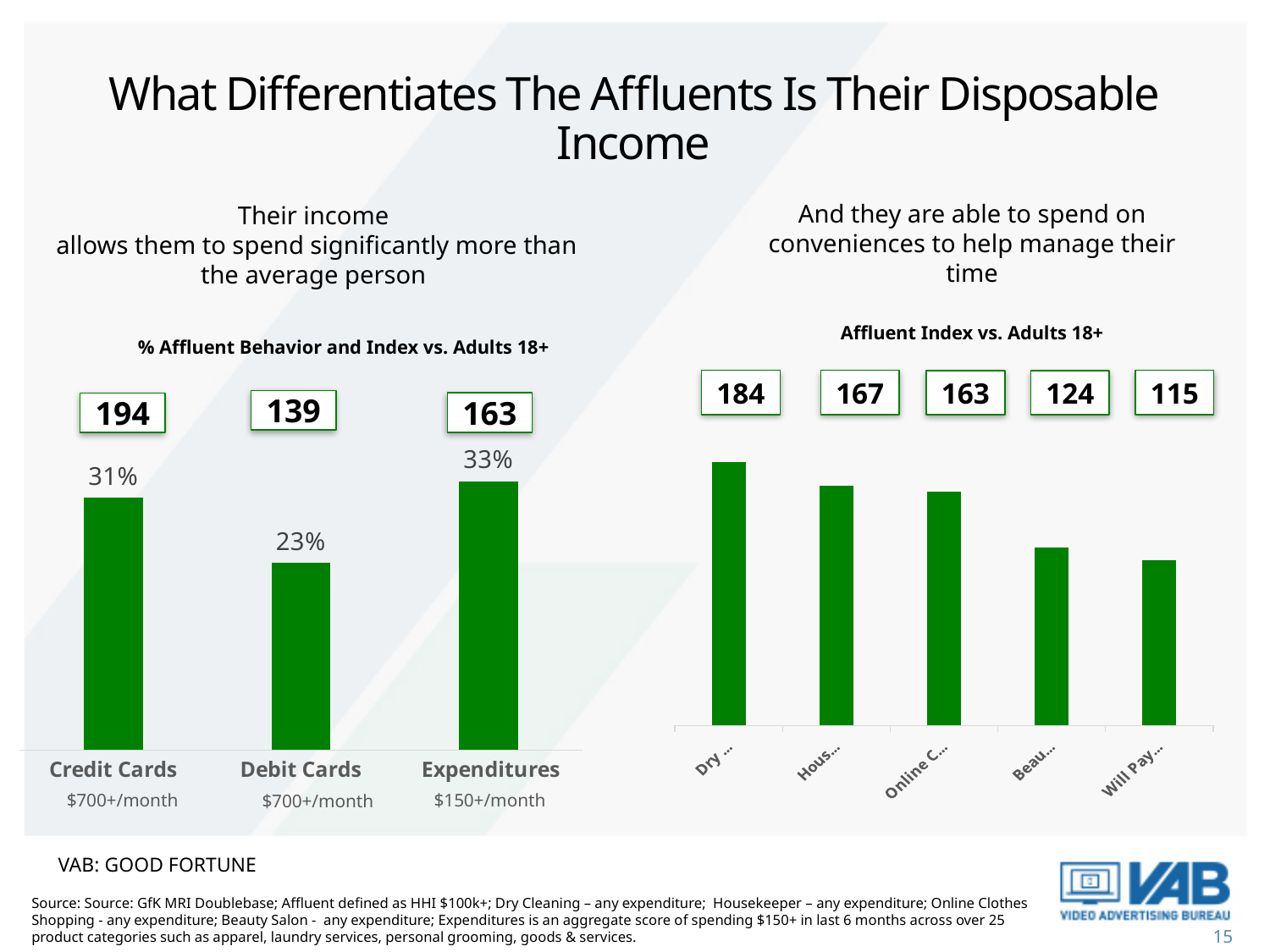
In the left chart '% Affluent Behavior and Index vs. Adults 18+', which category has the highest index value? Credit Cards In the left chart '% Affluent Behavior and Index vs. Adults 18+', what percentage is shown for Debit Cards? 23% In the right chart 'Affluent Index vs. Adults 18+', do the values rise or fall from left to right? fall In the right chart 'Affluent Index vs. Adults 18+', what is the index value of the leftmost bar? 184 In the left chart '% Affluent Behavior and Index vs. Adults 18+', what is the difference in percentage points between Expenditures and Debit Cards? 10 In the right chart 'Affluent Index vs. Adults 18+', how many bars are plotted? 5 In the left chart '% Affluent Behavior and Index vs. Adults 18+', what percentage is shown for Credit Cards? 31% In the left chart '% Affluent Behavior and Index vs. Adults 18+', what index value is shown above the Expenditures bar? 163 In the left chart '% Affluent Behavior and Index vs. Adults 18+', which category has the highest percentage? Expenditures In the right chart 'Affluent Index vs. Adults 18+', what is the index value of the rightmost bar? 115 What kind of chart is the right chart 'Affluent Index vs. Adults 18+'? bar chart In the left chart '% Affluent Behavior and Index vs. Adults 18+', how many categories are plotted? 3